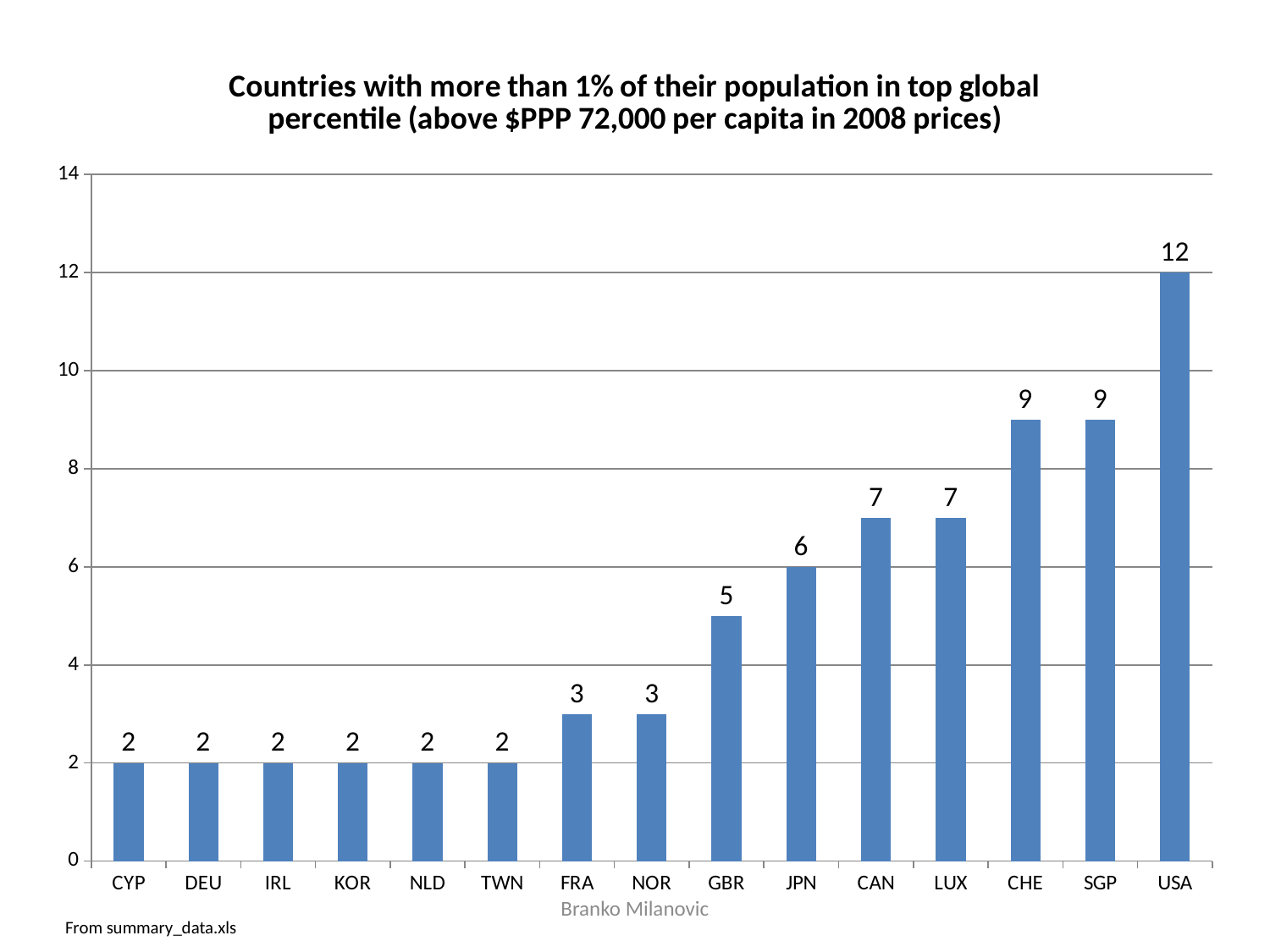
What is the difference between the values for CAN and FRA? 4 Is the value for SGP greater or less than 8? greater What is the value for GBR? 5 What is the value for USA? 12 What is the difference between the values for USA and CHE? 3 Do the values rise or fall from left to right along the x axis? rise What kind of chart is shown on the slide? bar chart What is the value for JPN? 6 Which is larger, the value for JPN or the value for NOR? JPN How many countries have a value of 2? 6 How many countries are shown on the x axis? 15 Which country has the highest value? USA